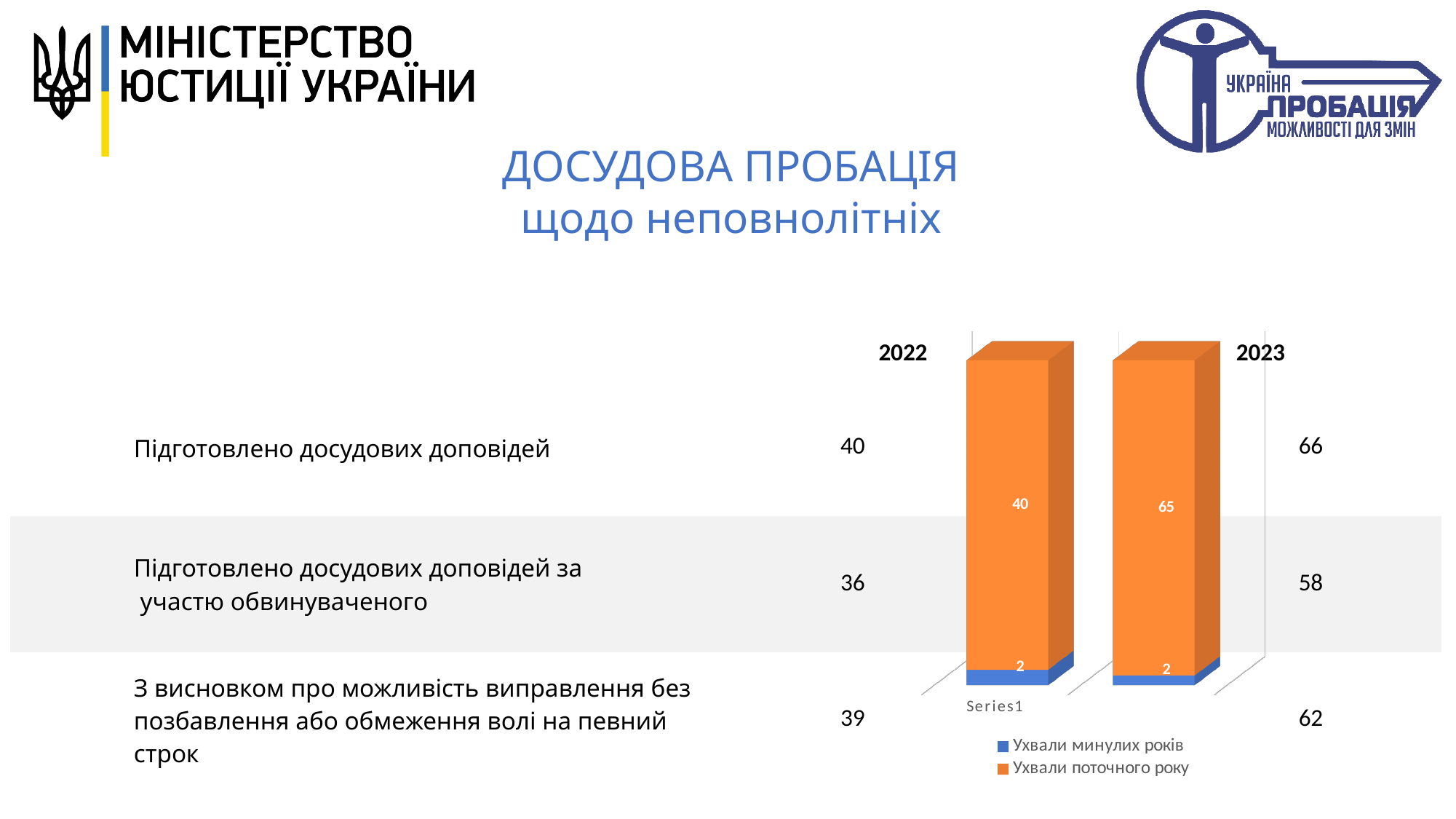
How many series does the chart legend list? 2 What is the total of the stacked bar for 2022? 42 What are the two series named in the chart legend? Ухвали минулих років, Ухвали поточного року How many stacked bars are plotted in the chart? 2 What is the value of 'Ухвали минулих років' for the 2023 bar? 2 What is the value of 'Ухвали минулих років' for the 2022 bar? 2 What is the value of 'Ухвали поточного року' for the 2022 bar? 40 What kind of chart is shown on the slide? bar chart Which bar has the higher value for 'Ухвали поточного року', 2022 or 2023? 2023 What is the difference between the 'Ухвали поточного року' values for 2023 and 2022? 25 What is the total of the stacked bar for 2023? 67 What is the value of 'Ухвали поточного року' for the 2023 bar? 65